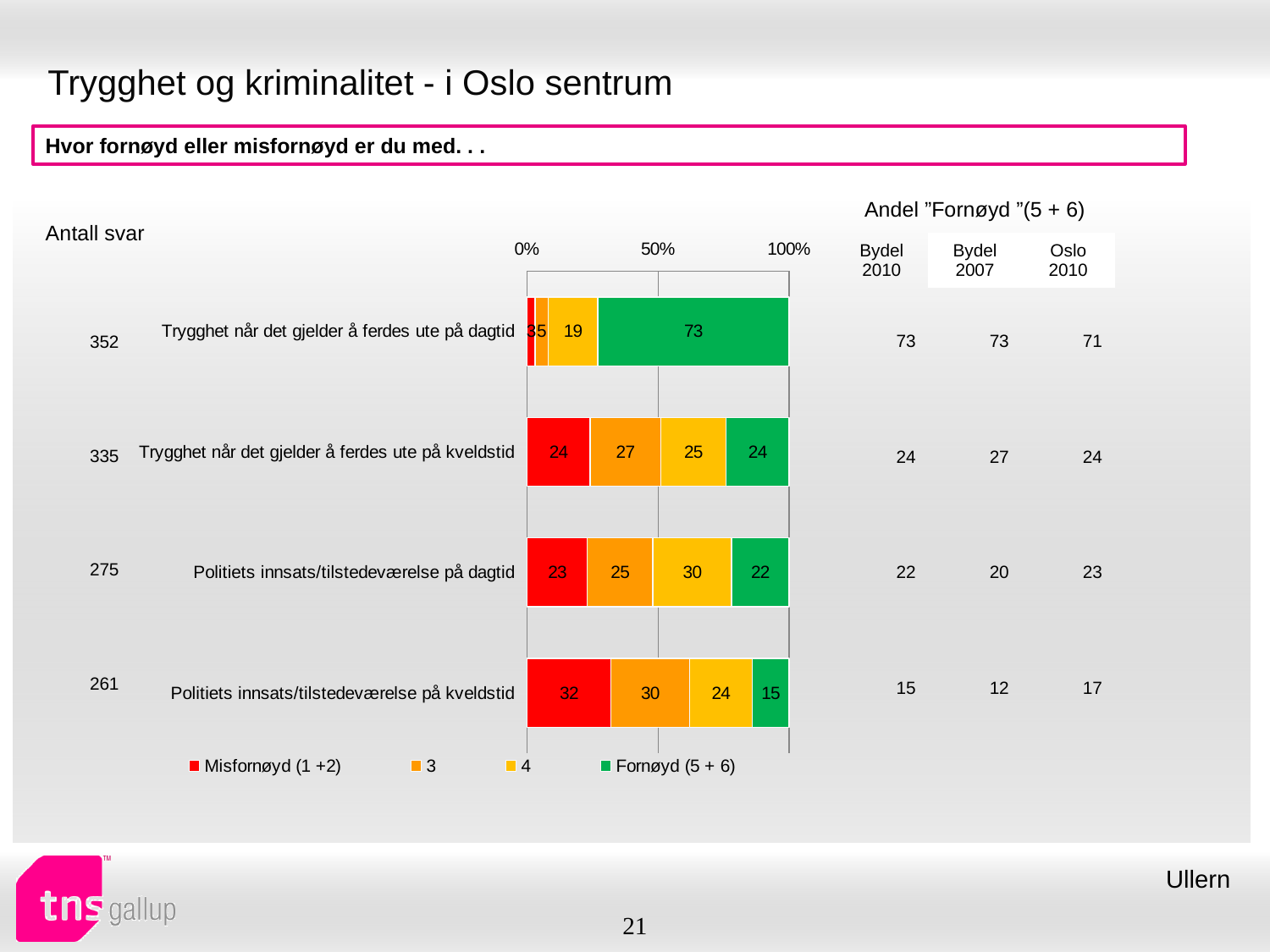
What is the 'Antall svar' shown for 'Politiets innsats/tilstedeværelse på dagtid'? 275 What is the value of series '4' for 'Politiets innsats/tilstedeværelse på dagtid'? 30 What is the difference between the 'Misfornøyd (1 +2)' values for 'Politiets innsats/tilstedeværelse på kveldstid' and 'Politiets innsats/tilstedeværelse på dagtid'? 9 How many categories (rows) does the bar chart show? 4 What is the 'Misfornøyd (1 +2)' value for 'Politiets innsats/tilstedeværelse på kveldstid'? 32 Which category has the lowest 'Fornøyd (5 + 6)' value? Politiets innsats/tilstedeværelse på kveldstid What kind of chart is shown on the slide? stacked bar chart Which category has the highest 'Fornøyd (5 + 6)' value? Trygghet når det gjelder å ferdes ute på dagtid What is the value of series '3' for 'Trygghet når det gjelder å ferdes ute på kveldstid'? 27 Which is larger: the 'Fornøyd (5 + 6)' value for 'Trygghet når det gjelder å ferdes ute på kveldstid' or for 'Politiets innsats/tilstedeværelse på kveldstid'? Trygghet når det gjelder å ferdes ute på kveldstid How many series does the legend list? 4 What is the 'Fornøyd (5 + 6)' value for 'Trygghet når det gjelder å ferdes ute på dagtid'? 73